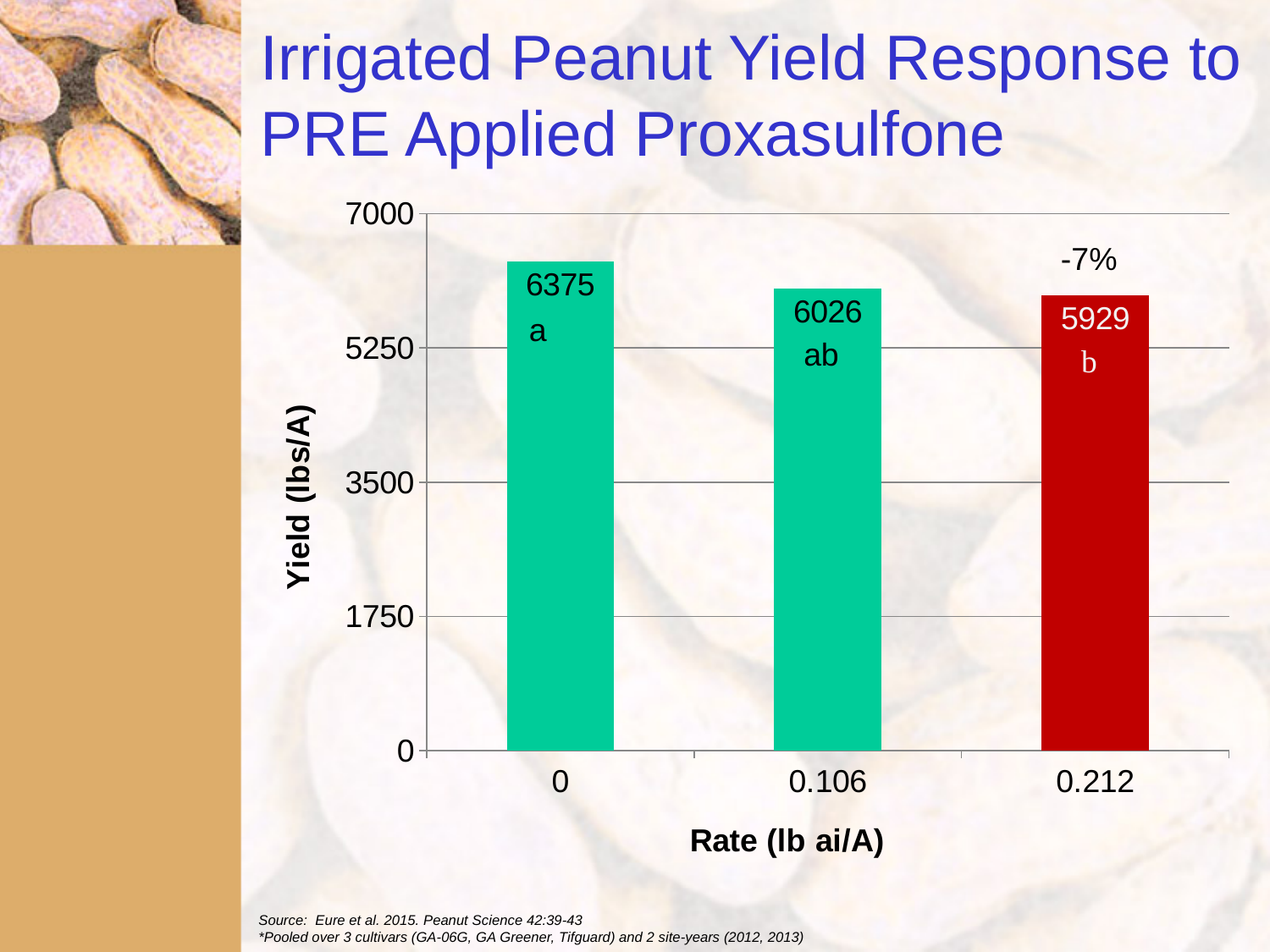
What is the difference in yield between the 0 rate and the 0.106 rate? 349 Which has a larger yield, the 0.106 rate or the 0.212 rate? 0.106 What is the yield at a rate of 0.106 lb ai/A? 6026 What is the yield at a rate of 0 lb ai/A? 6375 What is the yield at a rate of 0.212 lb ai/A? 5929 Which rate has the highest yield? 0 How many rate categories are shown on the chart? 3 Which rate has the lowest yield? 0.212 Do yields rise or fall as the rate increases along the x axis? fall What kind of chart is shown on the slide? bar chart What percentage change is labelled above the 0.212 rate bar? -7% What is the difference in yield between the 0 rate and the 0.212 rate? 446